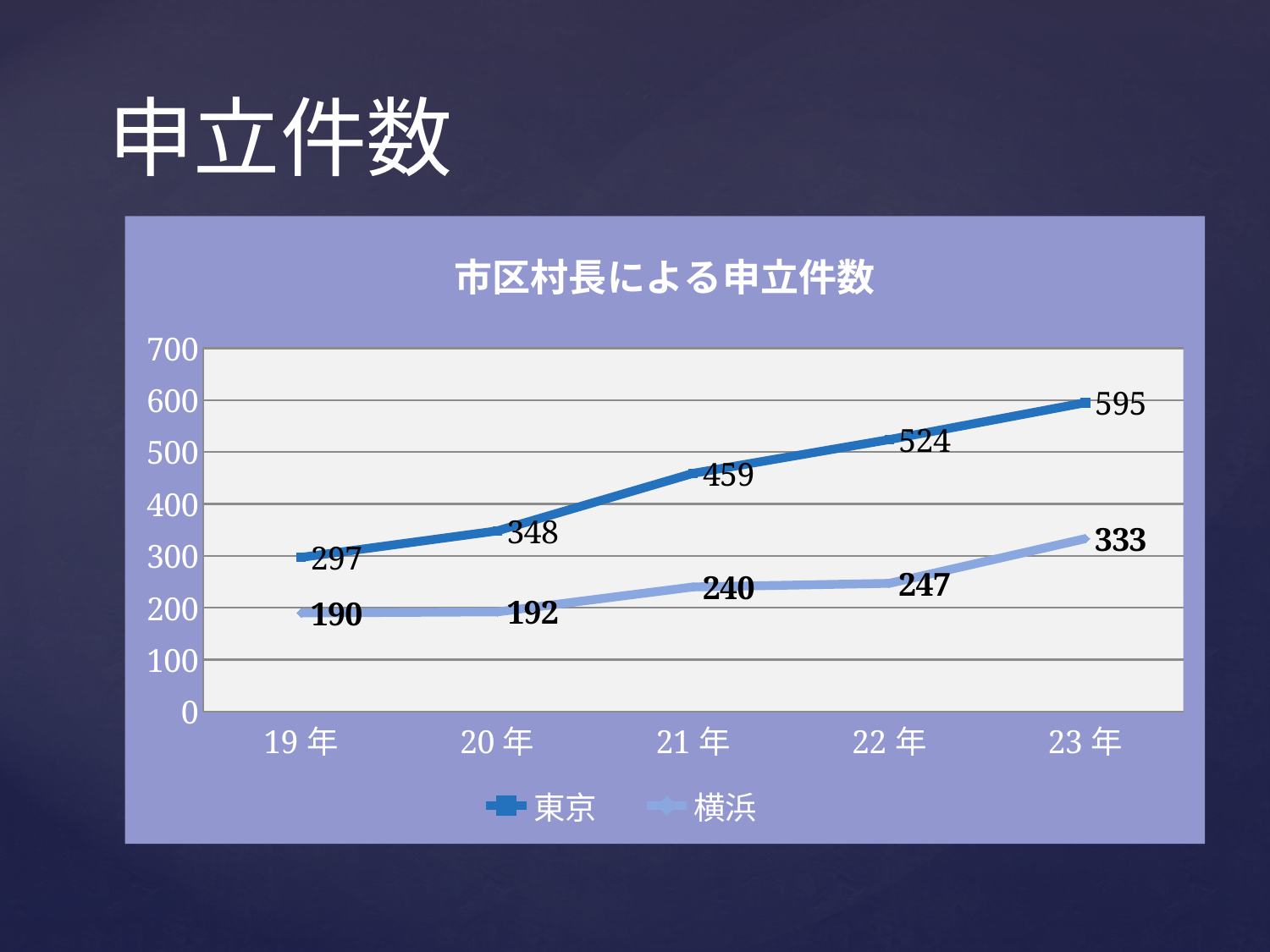
How many years are shown on the x axis? 5 What is the value for 横浜 in 22年? 247 What is the value for 東京 in 21年? 459 How many series does the legend list? 2 In which year is the value for 横浜 lowest? 19年 Do the values for 東京 rise or fall from 19年 to 23年? rise What is the difference between 東京 and 横浜 in 23年? 262 Which series has the larger value in 22年, 東京 or 横浜? 東京 What is the difference between the 東京 values in 20年 and 19年? 51 What type of chart is shown on the slide? line chart In which year is the value for 東京 highest? 23年 What is the value for 東京 in 19年? 297